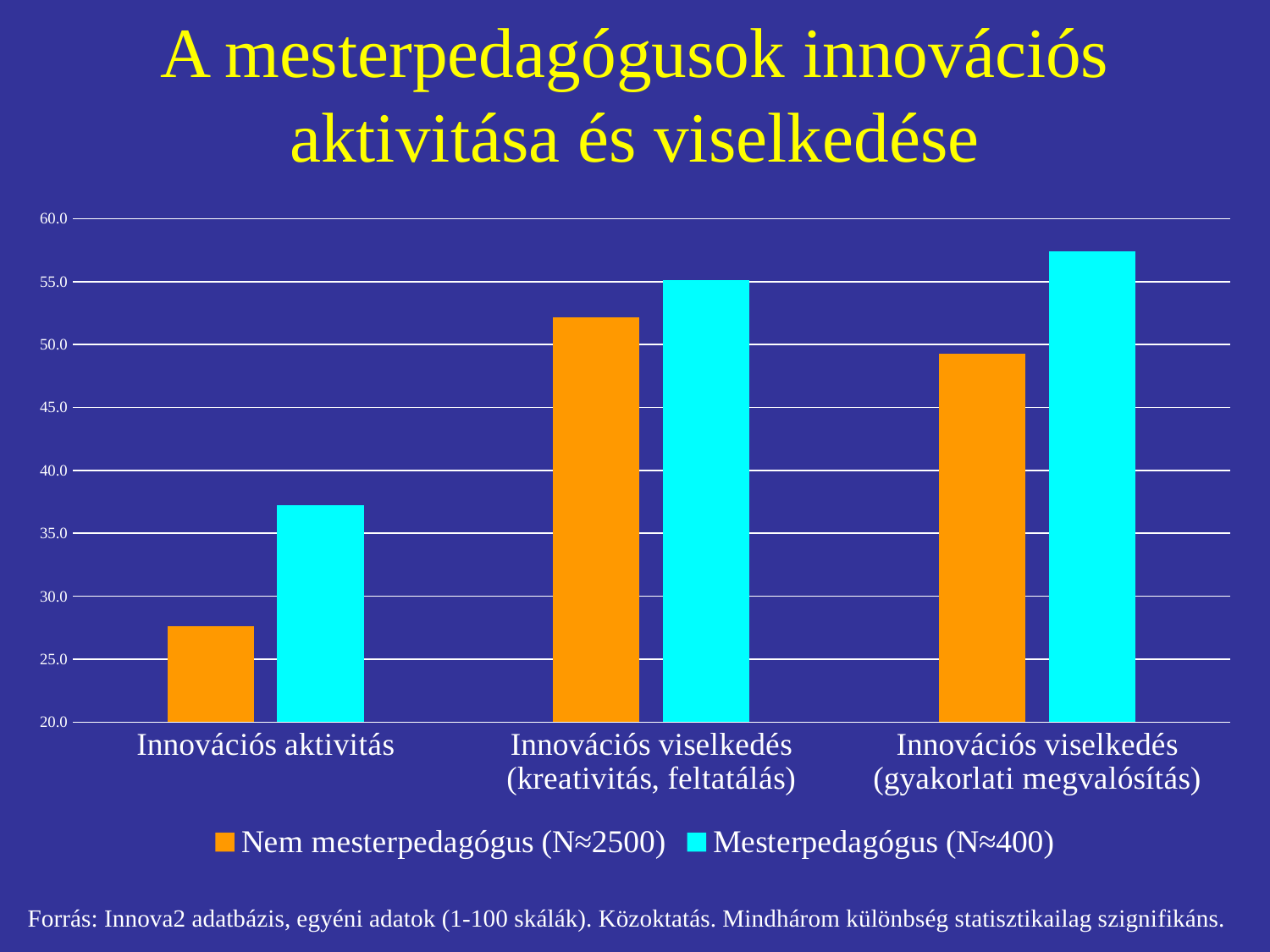
Is the value for Mesterpedagógus (N≈400) in Innovációs viselkedés (gyakorlati megvalósítás) greater or less than 55.0? greater Which category has the highest value for Nem mesterpedagógus (N≈2500)? Innovációs viselkedés (kreativitás, feltatálás) Is the value for Mesterpedagógus (N≈400) in Innovációs aktivitás greater or less than 35.0? greater How many series does the legend list? 2 Which category has the highest value for Mesterpedagógus (N≈400)? Innovációs viselkedés (gyakorlati megvalósítás) Which category has the lowest value for Nem mesterpedagógus (N≈2500)? Innovációs aktivitás What colour are the bars for the Mesterpedagógus (N≈400) series? cyan For Innovációs aktivitás, which series has the larger value: Nem mesterpedagógus (N≈2500) or Mesterpedagógus (N≈400)? Mesterpedagógus (N≈400) Is the value for Nem mesterpedagógus (N≈2500) in Innovációs aktivitás greater or less than 30.0? less How many categories are shown on the x axis of the chart? 3 What kind of chart is shown on the slide? bar chart